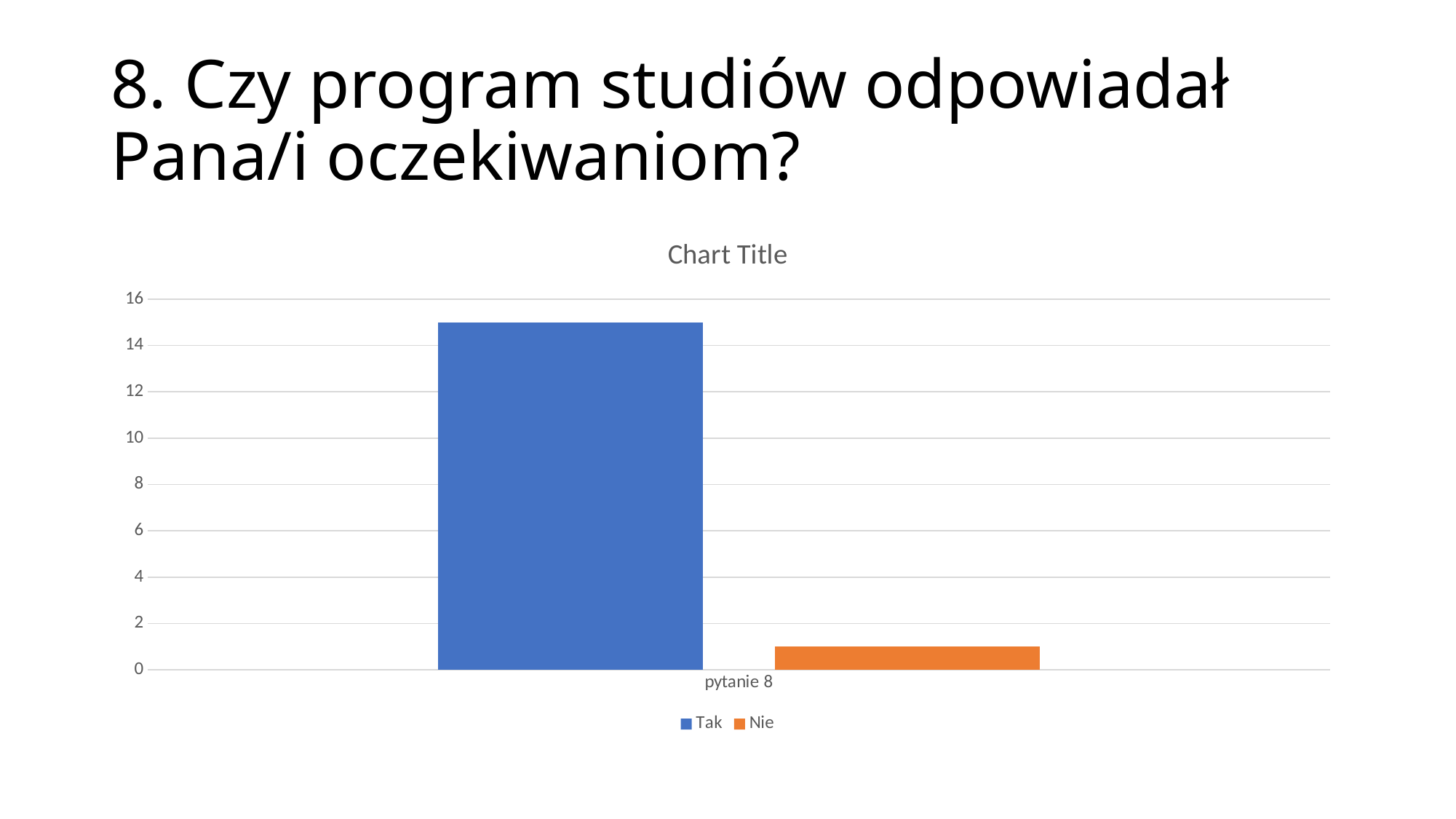
Is the value for Nie greater or less than 2? less What kind of chart is shown on the slide? bar chart How many categories are shown on the x axis? 1 Is the value for Tak greater or less than 14? greater Is the value for Tak greater or less than 16? less How many series does the legend list? 2 What is the title shown above the chart? Chart Title Which series has the highest value for pytanie 8? Tak Which series has the lowest value for pytanie 8? Nie What colour is the bar for the Nie series? orange Which is larger for pytanie 8, Tak or Nie? Tak